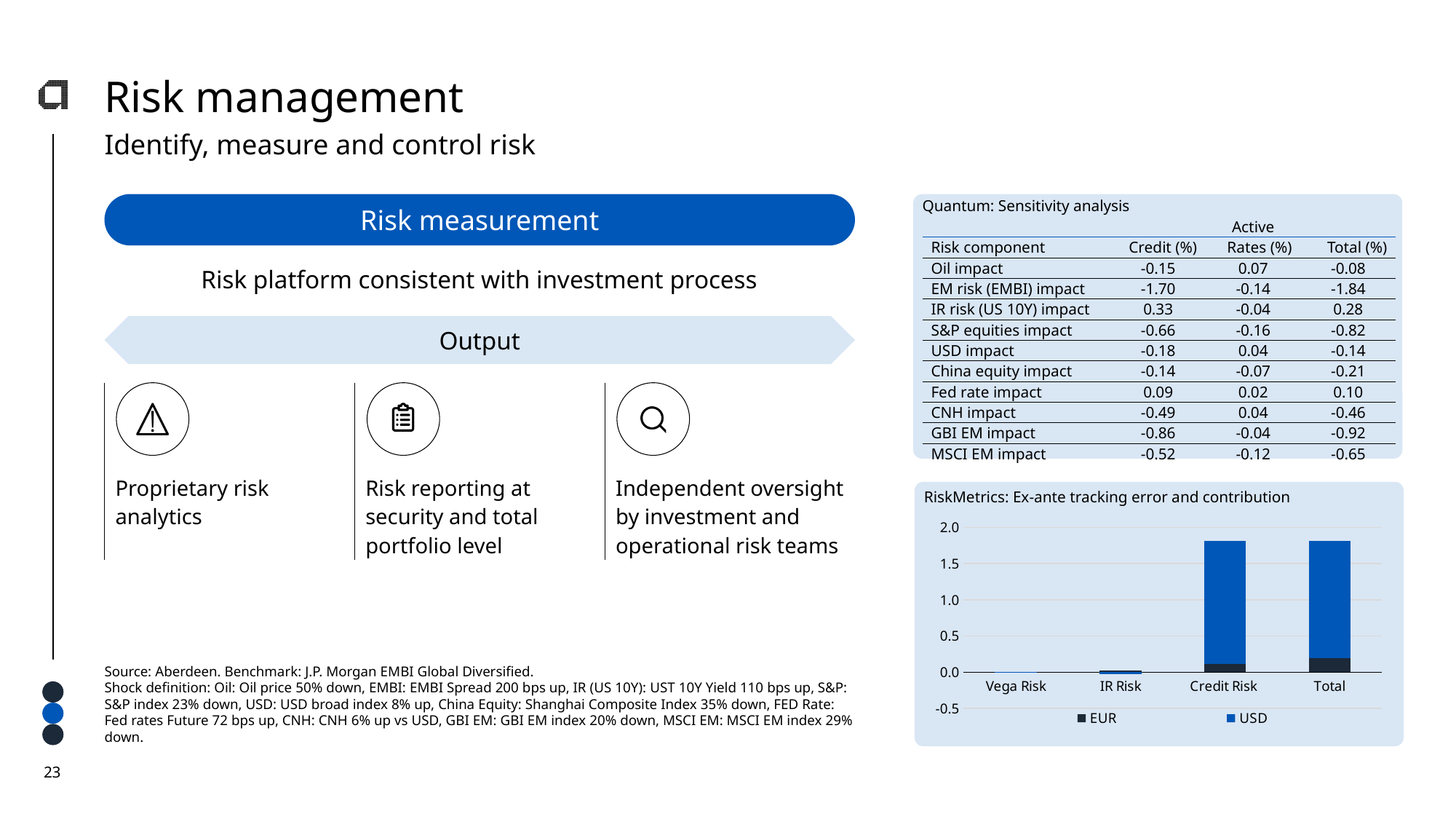
What are the two series named in the legend of the 'RiskMetrics: Ex-ante tracking error and contribution' chart? EUR and USD In the 'RiskMetrics: Ex-ante tracking error and contribution' chart, which is larger, the bar for Credit Risk or the bar for Vega Risk? Credit Risk In the 'RiskMetrics: Ex-ante tracking error and contribution' chart, is the value for Vega Risk greater or less than 0.5? less What is the highest value shown on the y axis of the 'RiskMetrics: Ex-ante tracking error and contribution' chart? 2.0 In the 'RiskMetrics: Ex-ante tracking error and contribution' chart, is the total value for Total greater or less than 1.0? greater In the 'RiskMetrics: Ex-ante tracking error and contribution' chart, is the total value for Credit Risk greater or less than 1.5? greater In the 'RiskMetrics: Ex-ante tracking error and contribution' chart, which is larger, the bar for Total or the bar for IR Risk? Total How many categories are shown on the x axis of the 'RiskMetrics: Ex-ante tracking error and contribution' chart? 4 How many series does the legend of the 'RiskMetrics: Ex-ante tracking error and contribution' chart list? 2 What kind of chart is the 'RiskMetrics: Ex-ante tracking error and contribution' chart? Stacked bar chart